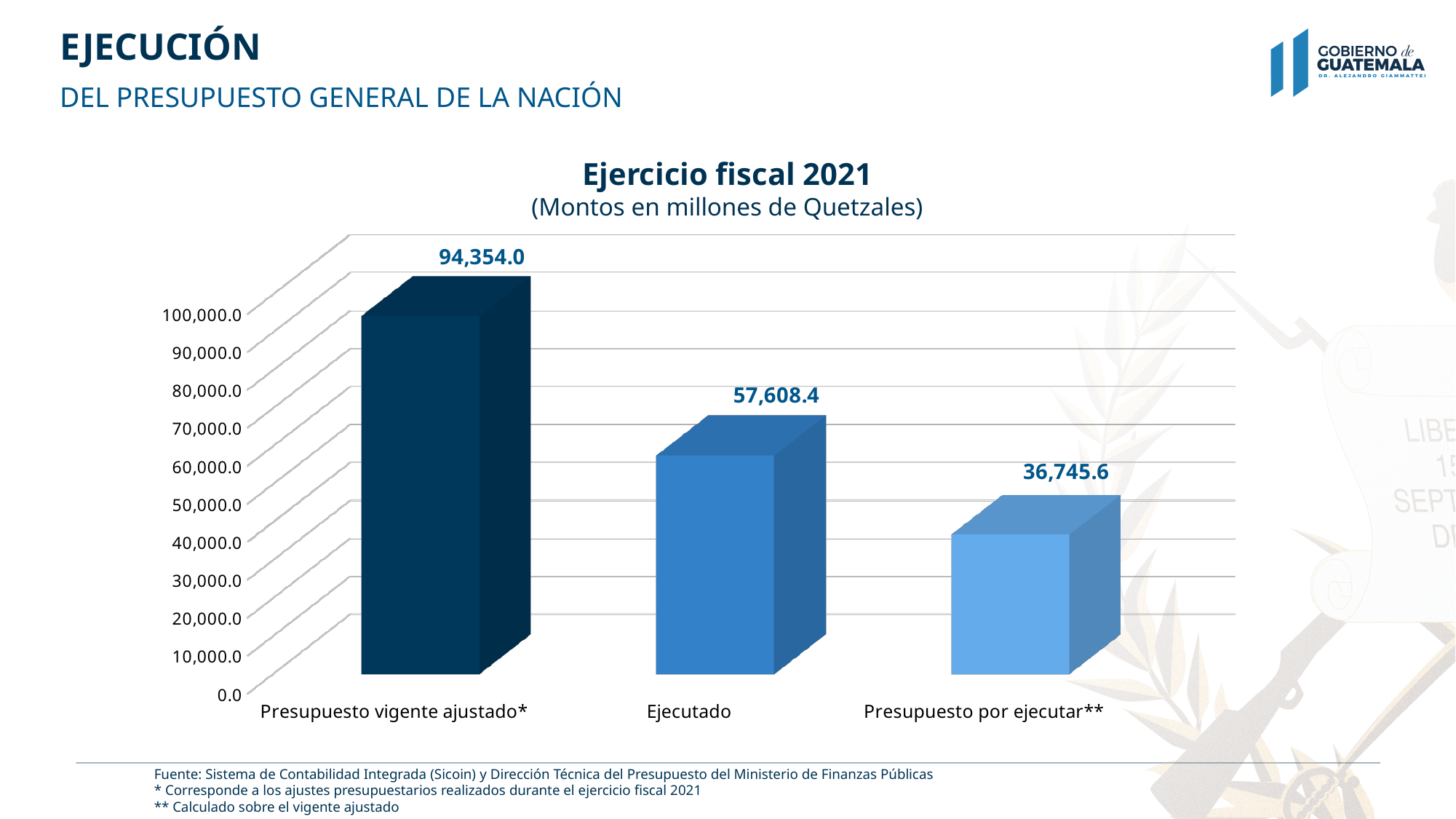
Is the value for Ejecutado greater or less than 50,000.0? greater What is the value for Ejecutado? 57,608.4 Which is larger, Ejecutado or Presupuesto por ejecutar**? Ejecutado What is the difference between Ejecutado and Presupuesto por ejecutar**? 20,862.8 Which category has the highest value? Presupuesto vigente ajustado* How many categories are shown in the chart? 3 What is the value for Presupuesto por ejecutar**? 36,745.6 What is the title of the chart? Ejercicio fiscal 2021 What is the value for Presupuesto vigente ajustado*? 94,354.0 What kind of chart is shown on the slide? Bar chart Which category has the lowest value? Presupuesto por ejecutar** What is the difference between Presupuesto vigente ajustado* and Ejecutado? 36,745.6